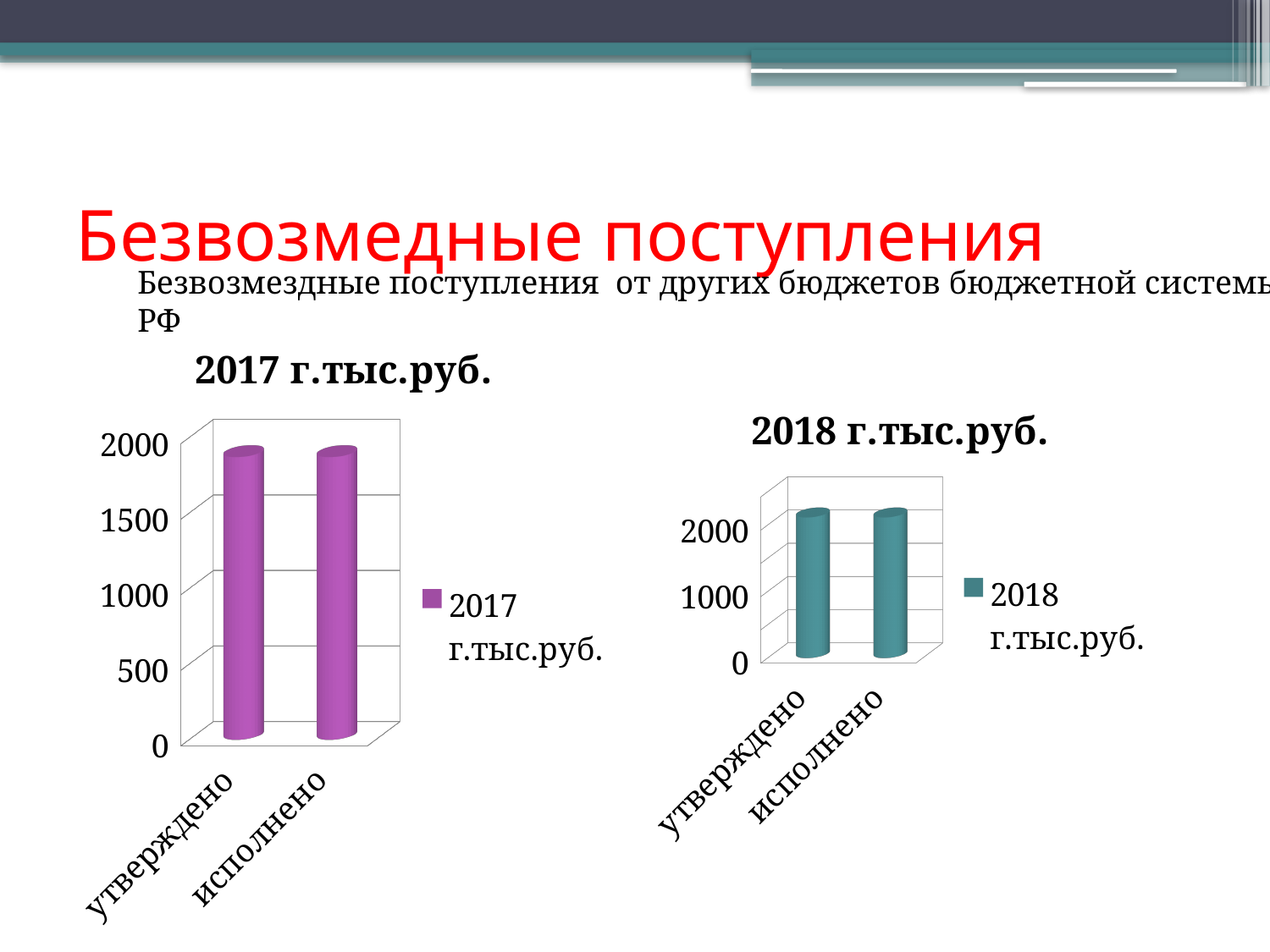
In the 2017 г.тыс.руб. chart, is the value for утверждено greater or less than 1500? greater What type of chart is the 2017 г.тыс.руб. chart? bar chart What colour are the bars in the 2017 г.тыс.руб. chart? purple How many series does the legend of the 2017 г.тыс.руб. chart list? 1 How many categories are shown on the x axis of the 2018 г.тыс.руб. chart? 2 In the 2017 г.тыс.руб. chart, is the value for исполнено greater or less than 2000? less How many series does the legend of the 2018 г.тыс.руб. chart list? 1 What is the legend entry of the 2018 г.тыс.руб. chart? 2018 г.тыс.руб. In the 2018 г.тыс.руб. chart, is the value for утверждено greater or less than 1000? greater How many categories are shown on the x axis of the 2017 г.тыс.руб. chart? 2